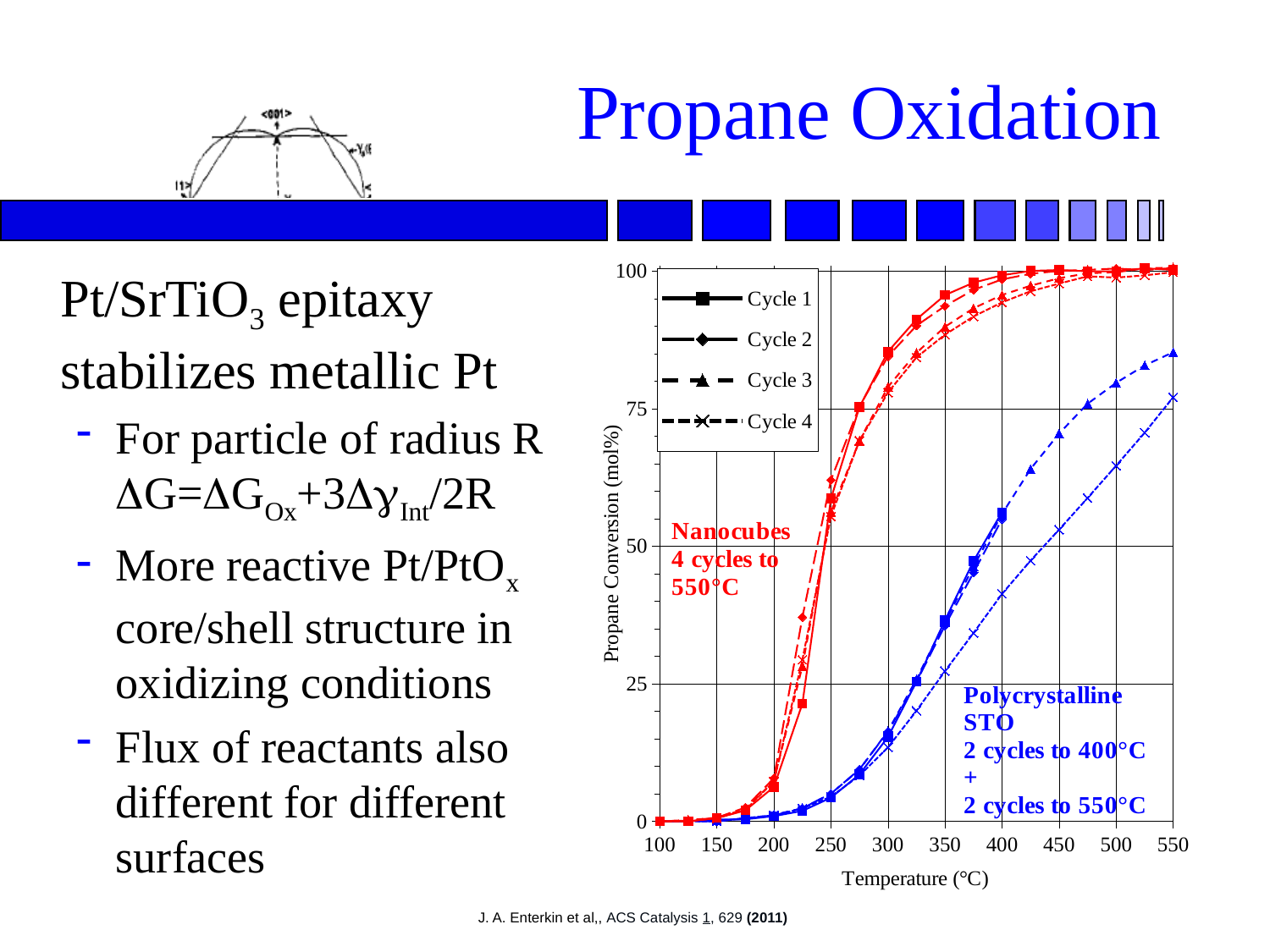
Is the propane conversion for the Nanocubes curves at 300°C greater or less than 75? greater At 550°C, which group has the higher propane conversion, Nanocubes or Polycrystalline STO? Nanocubes What is the label of the x axis of the chart? Temperature (°C) Is the propane conversion for the Polycrystalline STO Cycle 3 curve at 550°C greater or less than 75? greater Is the propane conversion for the Nanocubes curves at 200°C greater or less than 25? less Do the propane conversion values rise or fall as temperature increases along the x axis? rise What kind of chart is shown on the slide? line chart For the Polycrystalline STO curves at 400°C, which has the higher propane conversion, Cycle 3 or Cycle 4? Cycle 3 What is the highest value shown on the y axis of the chart? 100 What is the label of the y axis of the chart? Propane Conversion (mol%) How many series does the chart legend list? 4